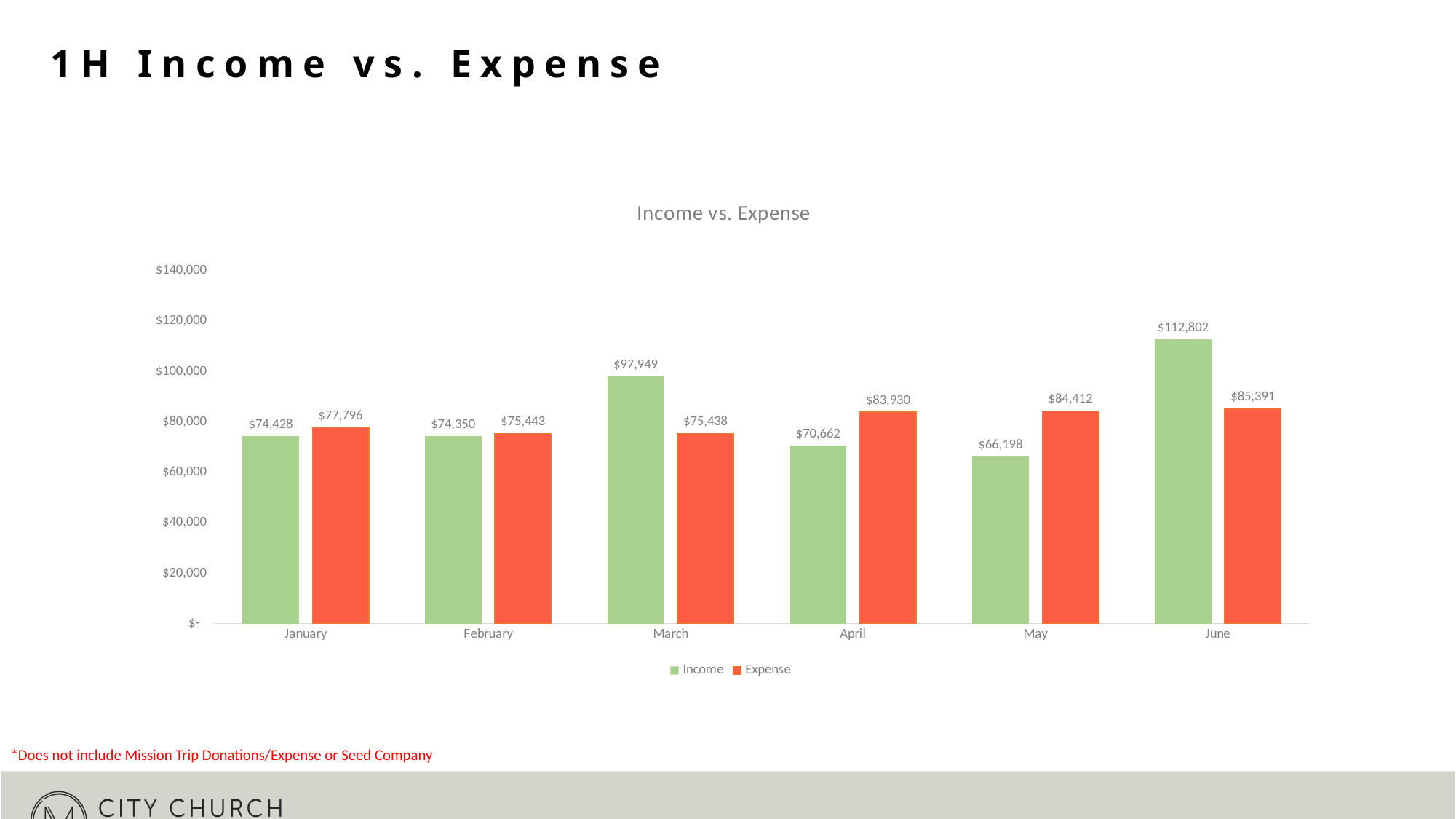
What type of chart is shown on the slide? Bar chart What is the Income value for June? $112,802 Which month has the lowest Income? May How many series does the legend list? 2 Which month has the highest Income? June What is the Income value for March? $97,949 Which month has the highest Expense? June What is the Expense value for May? $84,412 What is the difference between Expense and Income in May? $18,214 How many months are shown on the x axis? 6 In April, which is larger, Income or Expense? Expense What is the difference between Income and Expense in June? $27,411